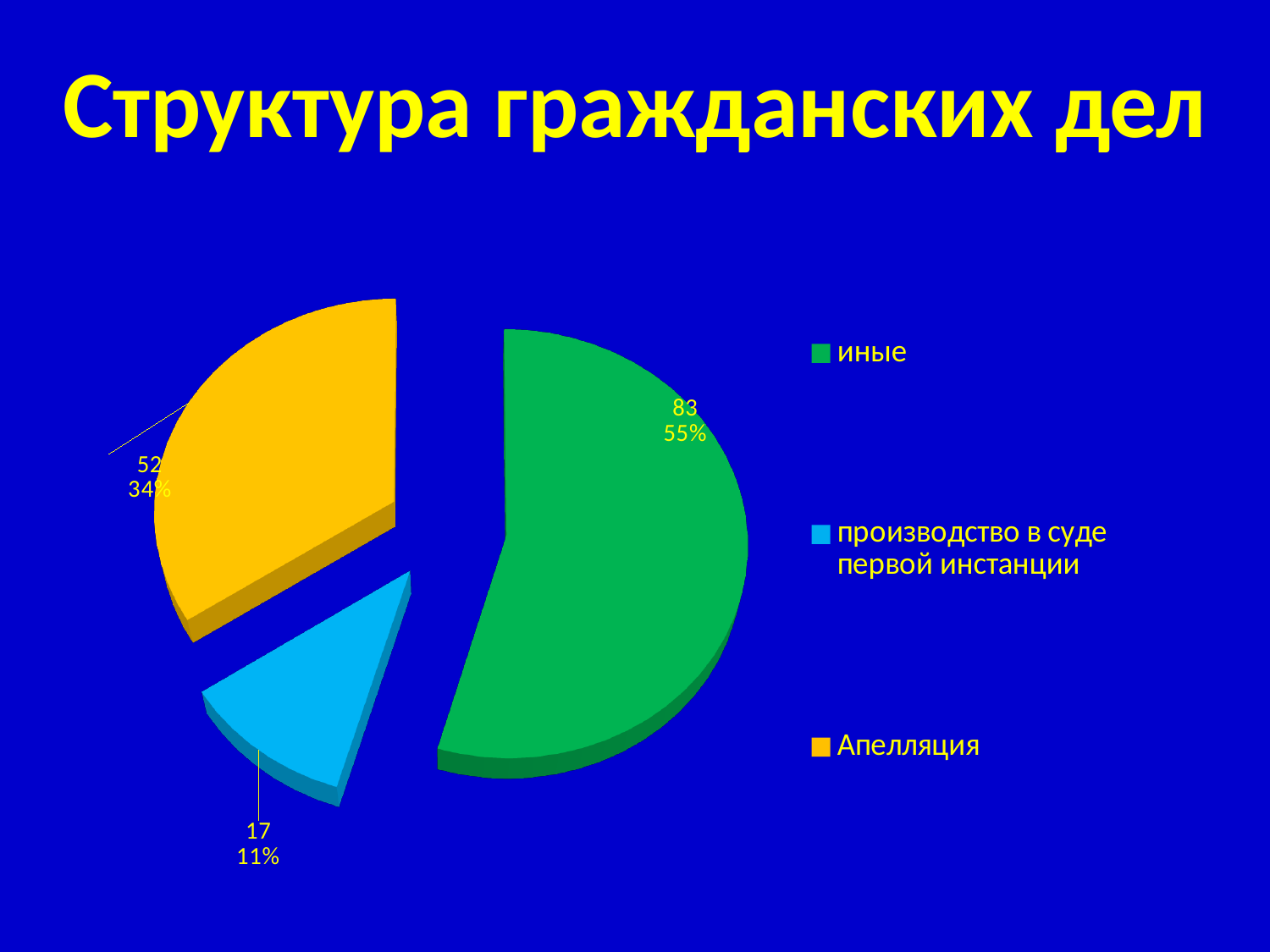
What is the value for "иные"? 83 What is the value for "Апелляция"? 52 What is the title of the chart? Структура гражданских дел How many slices does the pie chart have? 3 Which category has the smallest slice? производство в суде первой инстанции What is the value for "производство в суде первой инстанции"? 17 What share of the pie does "иные" represent? 55% What is the difference between the values for "иные" and "Апелляция"? 31 Which category has the largest slice? иные What share of the pie does "Апелляция" represent? 34% What kind of chart is shown on the slide? pie chart Which colour represents "Апелляция" in the legend? yellow